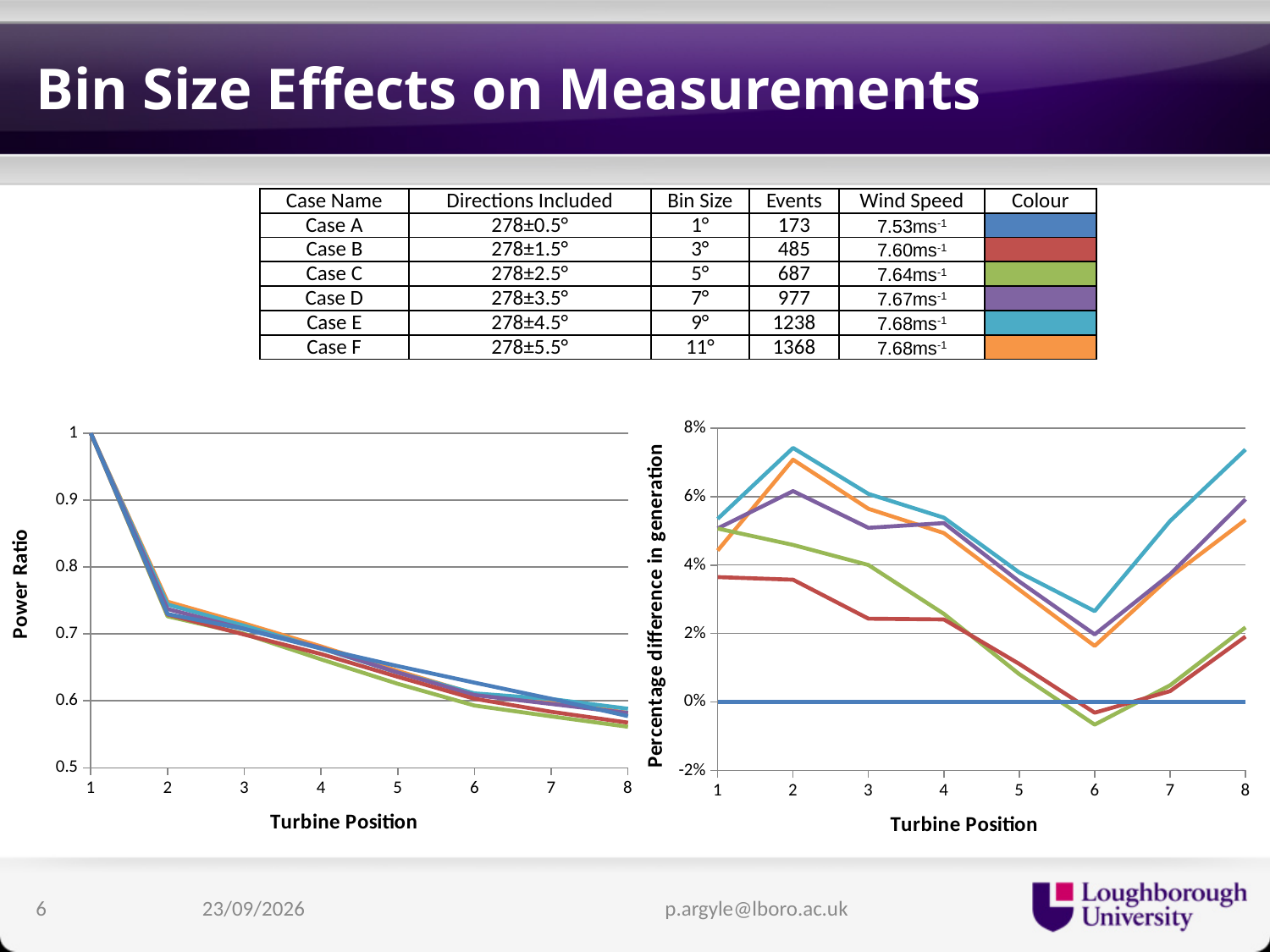
In the left chart, do the Power Ratio values rise or fall as turbine position increases from 1 to 8? fall In the left chart, is the Power Ratio at turbine position 8 greater or less than 0.6? less In the right chart, is the value of the red line (Case B) at turbine position 1 greater or less than 4%? less In the left chart, is the Power Ratio at turbine position 2 greater or less than 0.8? less In the left chart, how many turbine positions are shown on the x axis? 8 What kind of chart is the right chart (Percentage difference in generation vs Turbine Position)? line chart In the right chart, which turbine position has the lowest value for the green line (Case C)? 6 In the left chart, what is the Power Ratio at turbine position 1? 1 What is the x-axis title of both charts? Turbine Position What kind of chart is the left chart (Power Ratio vs Turbine Position)? line chart In the right chart, what is the percentage difference in generation for the blue line (Case A) at every turbine position? 0%